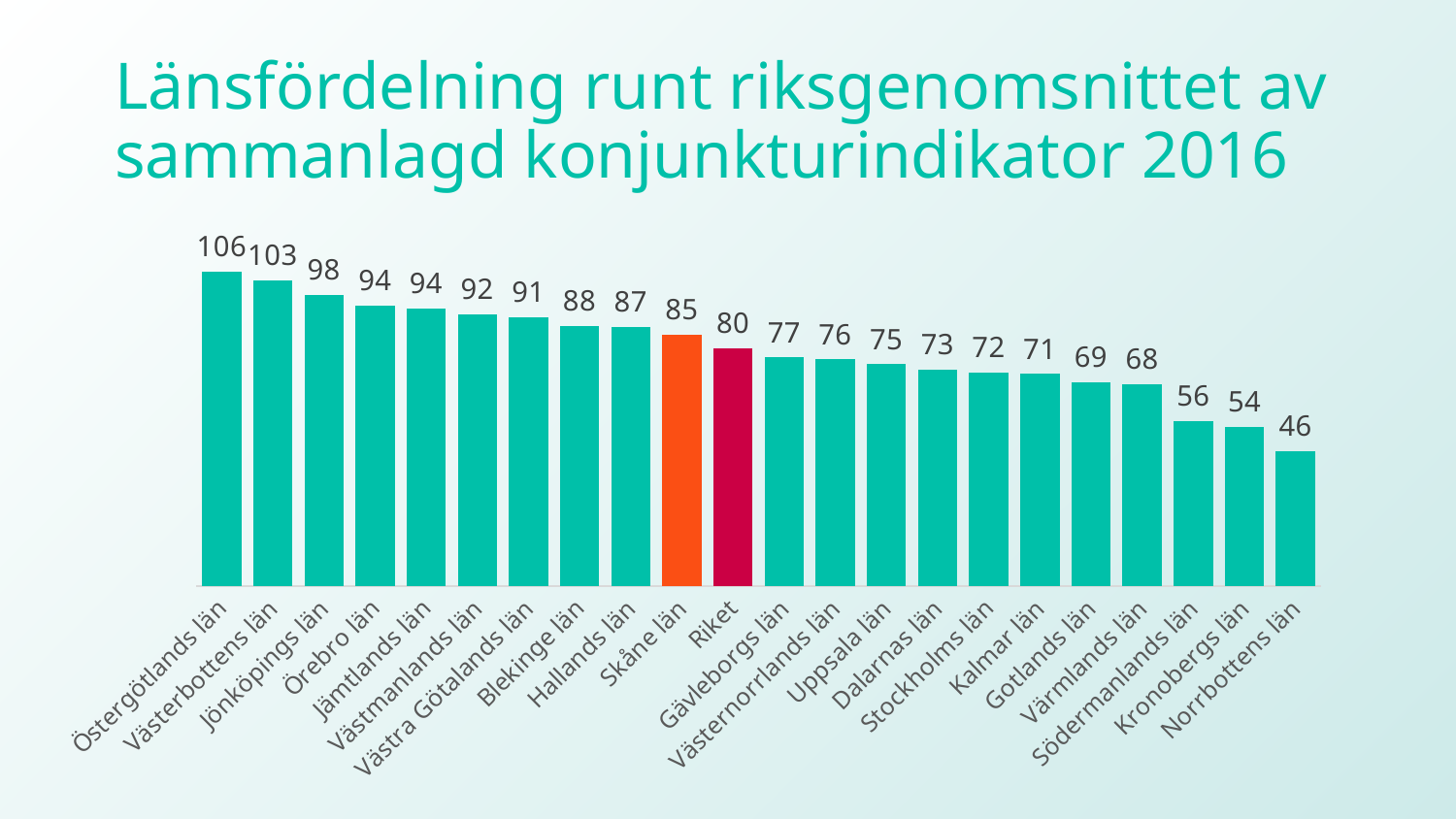
What is the difference between the values for Östergötlands län and Norrbottens län? 60 Which is larger, the value for Uppsala län or the value for Dalarnas län? Uppsala län Which category has the highest value? Östergötlands län How many bars are shown in the chart? 22 Which bar is coloured orange? Skåne län Which category has the lowest value? Norrbottens län What is the value for Stockholms län? 72 What is the value for Skåne län? 85 What kind of chart is shown on the slide? Bar chart What is the difference between the values for Skåne län and Riket? 5 What is the value for Riket? 80 Do the values rise or fall from left to right along the x axis? Fall